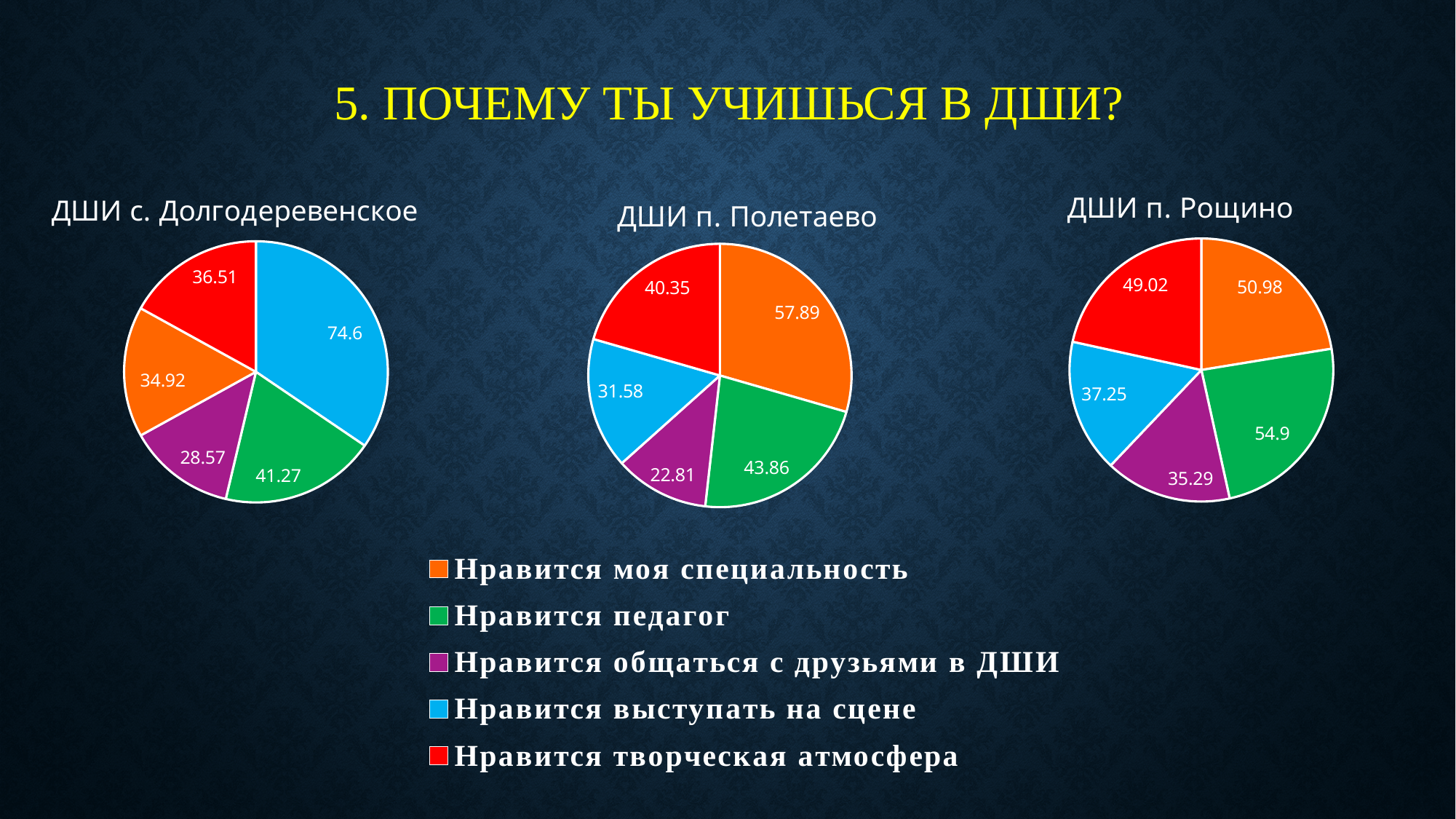
How many entries does the legend list? 5 In the ДШИ с. Долгодеревенское chart, what is the value for Нравится выступать на сцене? 74.6 In the ДШИ п. Полетаево chart, which category has the highest value? Нравится моя специальность In the ДШИ п. Полетаево chart, what is the difference between Нравится моя специальность and Нравится педагог? 14.03 In the ДШИ п. Рощино chart, which category has the highest value? Нравится педагог In the ДШИ с. Долгодеревенское chart, which is larger: Нравится творческая атмосфера or Нравится моя специальность? Нравится творческая атмосфера In the ДШИ п. Полетаево chart, what is the value for Нравится моя специальность? 57.89 In the ДШИ п. Рощино chart, what is the difference between Нравится выступать на сцене and Нравится общаться с друзьями в ДШИ? 1.96 In the ДШИ с. Долгодеревенское chart, which category has the lowest value? Нравится общаться с друзьями в ДШИ How many slices does the ДШИ п. Полетаево pie chart have? 5 In the ДШИ п. Рощино chart, what is the value for Нравится общаться с друзьями в ДШИ? 35.29 What type of chart is used for ДШИ п. Рощино? Pie chart